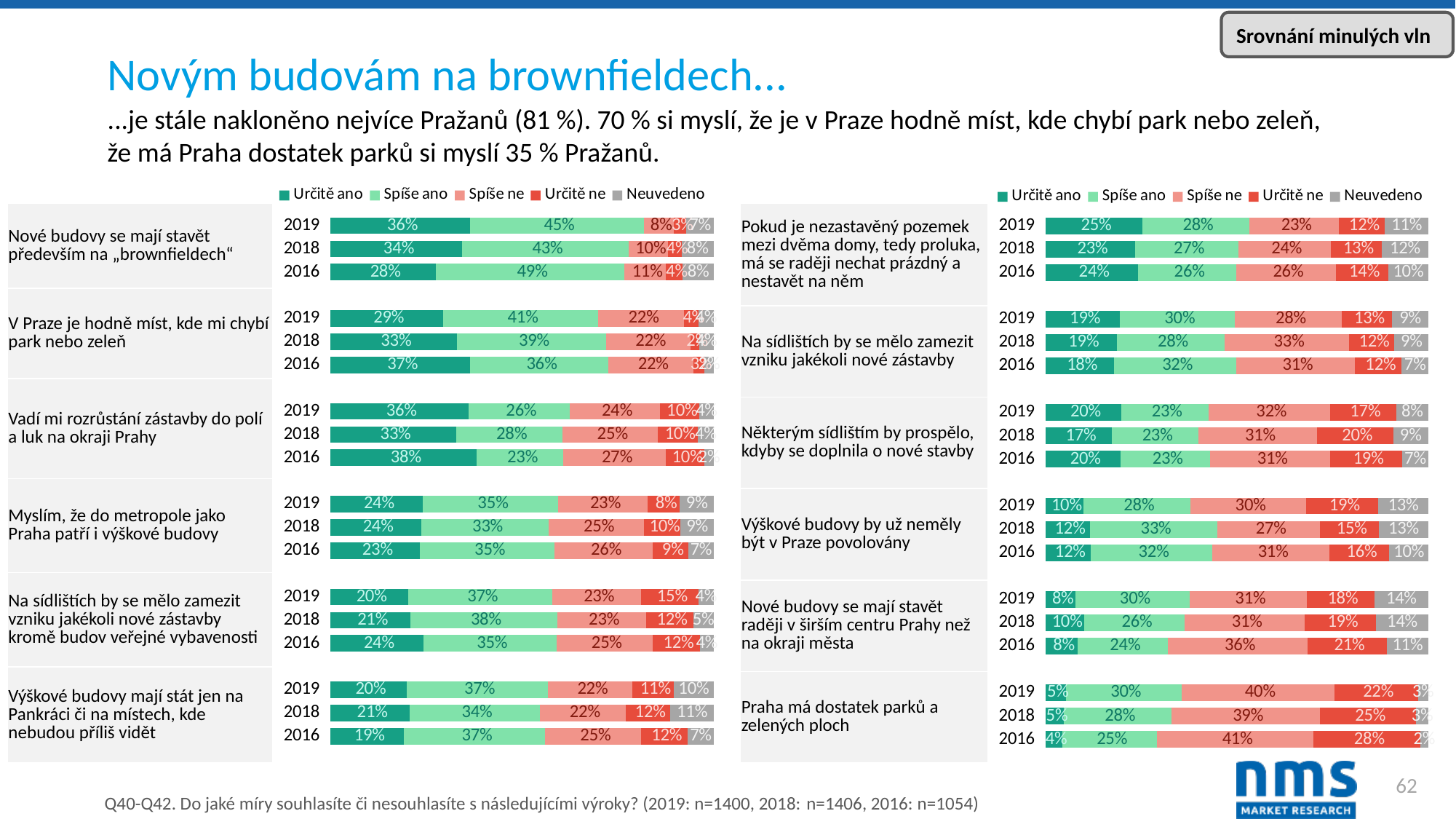
In the left chart, for "V Praze je hodně míst, kde mi chybí park nebo zeleň", how much did the "Určitě ano" share fall from 2016 to 2019? 8 percentage points In the left chart, what share of respondents answered "Určitě ano" in 2019 to the statement "Nové budovy se mají stavět především na „brownfieldech“"? 36% In the left chart, what is the combined share of "Určitě ano" and "Spíše ano" in 2019 for "Nové budovy se mají stavět především na „brownfieldech“"? 81% In the right chart, what share answered "Určitě ne" in 2016 to "Nové budovy se mají stavět raději v širším centru Prahy než na okraji města"? 21% How many statements are shown in the left chart? 6 In the left chart, what is the "Neuvedeno" value for 2018 for "Výškové budovy mají stát jen na Pankráci či na místech, kde nebudou příliš vidět"? 11% In the right chart, for "Výškové budovy by už neměly být v Praze povolovány", is the 2019 "Spíše ano" share larger or smaller than the 2018 "Spíše ano" share? Smaller In the right chart, how does the "Určitě ne" share for "Praha má dostatek parků a zelených ploch" change from 2016 to 2019? It falls (28% to 25% to 22%) In the right chart, which year has the highest "Určitě ne" share for "Některým sídlištím by prospělo, kdyby se doplnila o nové stavby"? 2018 In the right chart, what share answered "Spíše ne" in 2019 to "Praha má dostatek parků a zelených ploch"? 40% How many series does the legend of the left chart list? 5 What kind of chart is used on the slide to show the responses? Stacked bar chart